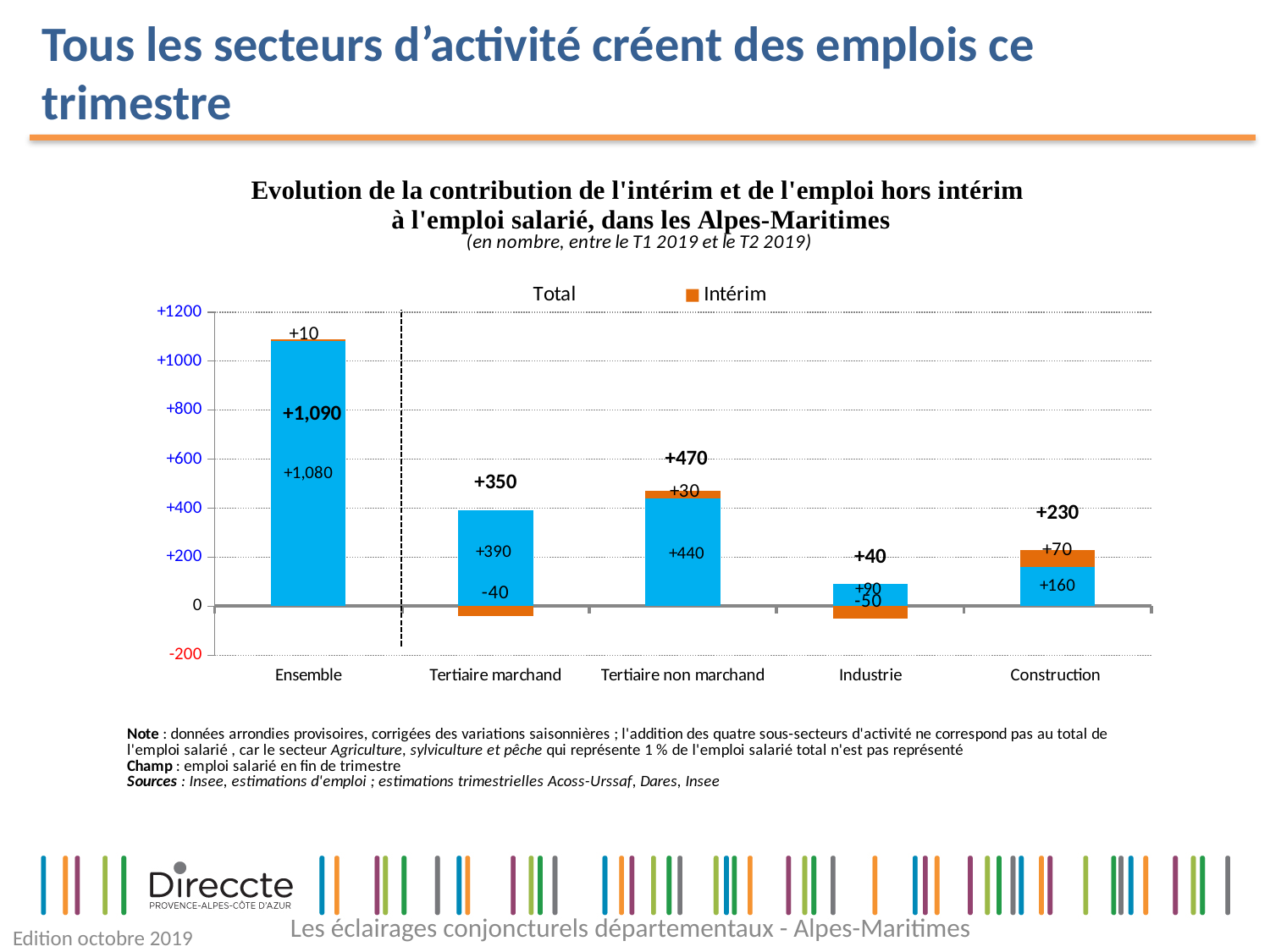
What is the blue (non-Intérim) value for Tertiaire non marchand? +440 What is the Intérim value for Industrie? -50 Which has a larger total value, Construction or Industrie? Construction What kind of chart is this? Bar chart What is the difference between the total for Tertiaire non marchand and the total for Tertiaire marchand? 120 What is the Intérim value for Tertiaire marchand? -40 How many categories are shown on the x axis? 5 Which category has the lowest total value? Industrie What is the total value shown for Construction? +230 What is the total value shown for Ensemble? +1,090 Which category has the highest total value? Ensemble Which series is shown in orange according to the legend? Intérim